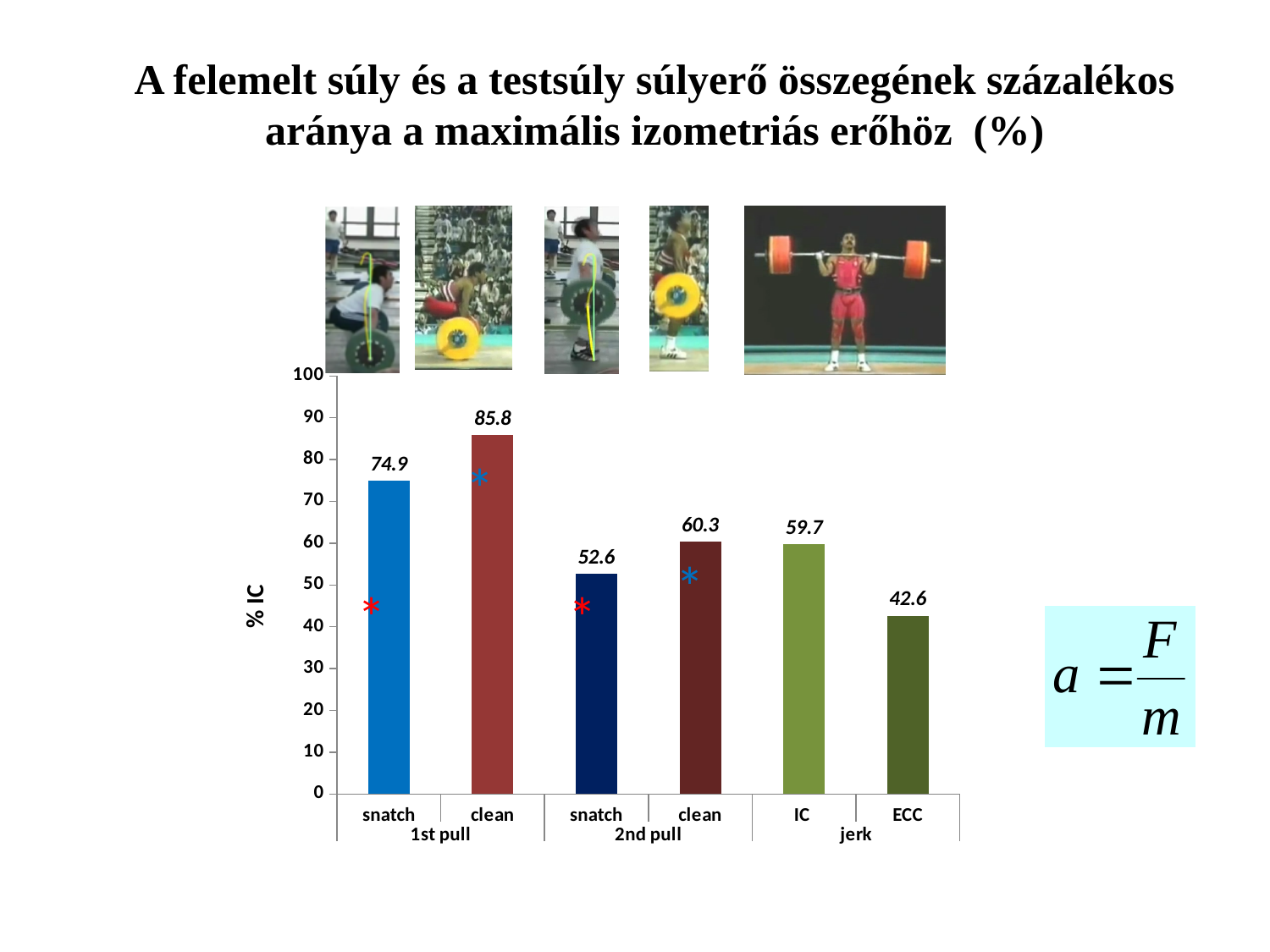
Is the value for snatch in the 2nd pull group greater or less than 50? greater What is the value for snatch in the 2nd pull group? 52.6 What is the value for snatch in the 1st pull group? 74.9 What is the label of the vertical axis? % IC Which is larger, the clean value in the 2nd pull group or the IC value in the jerk group? clean (2nd pull) Which bar has the highest value? clean (1st pull) What kind of chart is shown on the slide? bar chart What is the value for clean in the 1st pull group? 85.8 How many bars are plotted in the chart? 6 What is the difference between the clean and snatch values in the 1st pull group? 10.9 Which bar has the lowest value? ECC (jerk) What is the value for ECC in the jerk group? 42.6